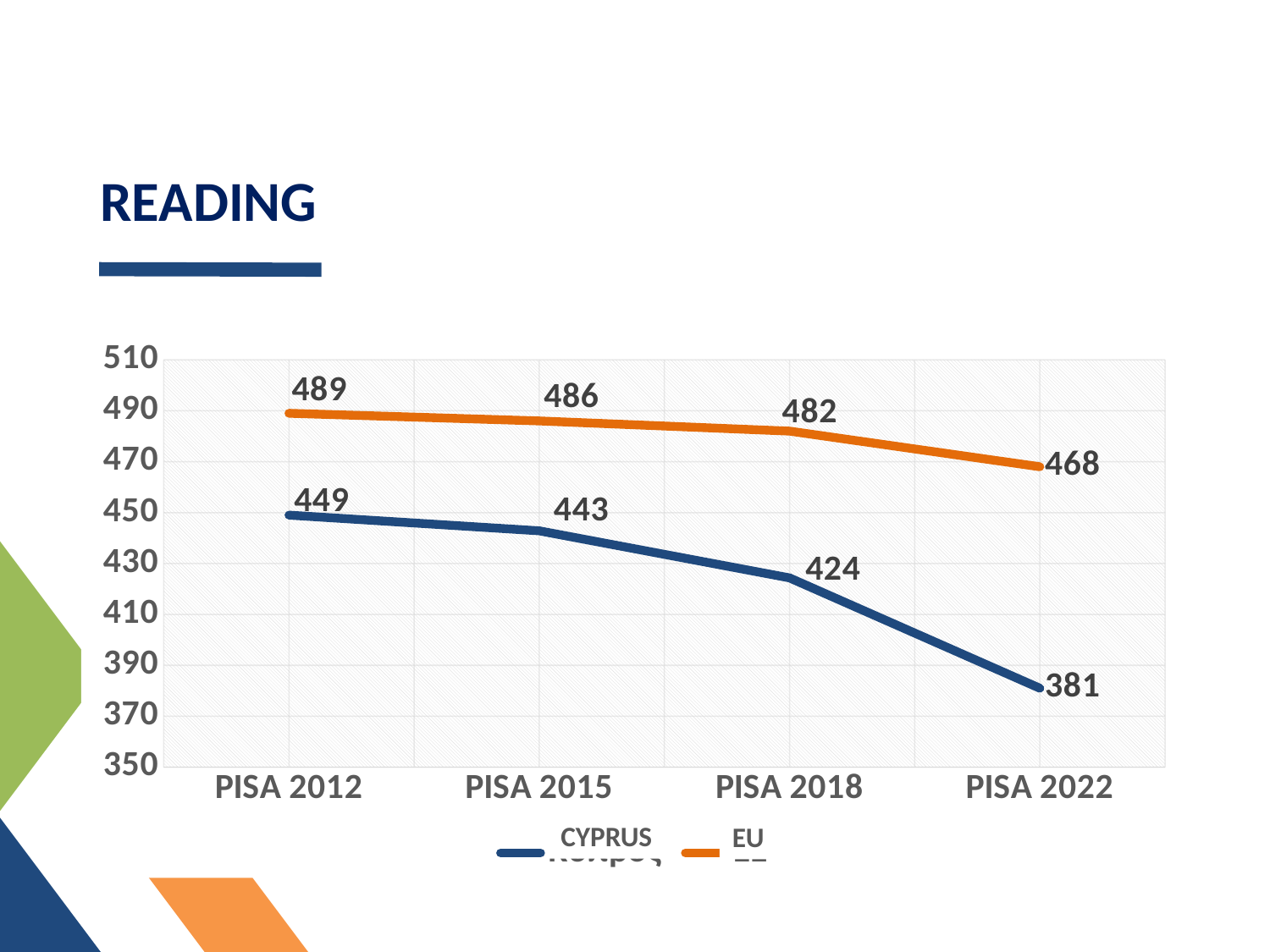
What kind of chart is shown on the slide? Line chart In which PISA round is the Cyprus reading score lowest? PISA 2022 What is the reading score for the EU in PISA 2012? 489 Do the Cyprus reading scores rise or fall from PISA 2012 to PISA 2022? Fall How many series does the legend list? 2 What is the reading score for Cyprus in PISA 2022? 381 In which PISA round is the EU reading score highest? PISA 2012 Which has the higher reading score in PISA 2015, Cyprus or the EU? EU What is the difference between the EU and Cyprus reading scores in PISA 2022? 87 How many PISA rounds are shown on the x axis? 4 What is the reading score for Cyprus in PISA 2018? 424 By how much did the Cyprus reading score fall from PISA 2018 to PISA 2022? 43